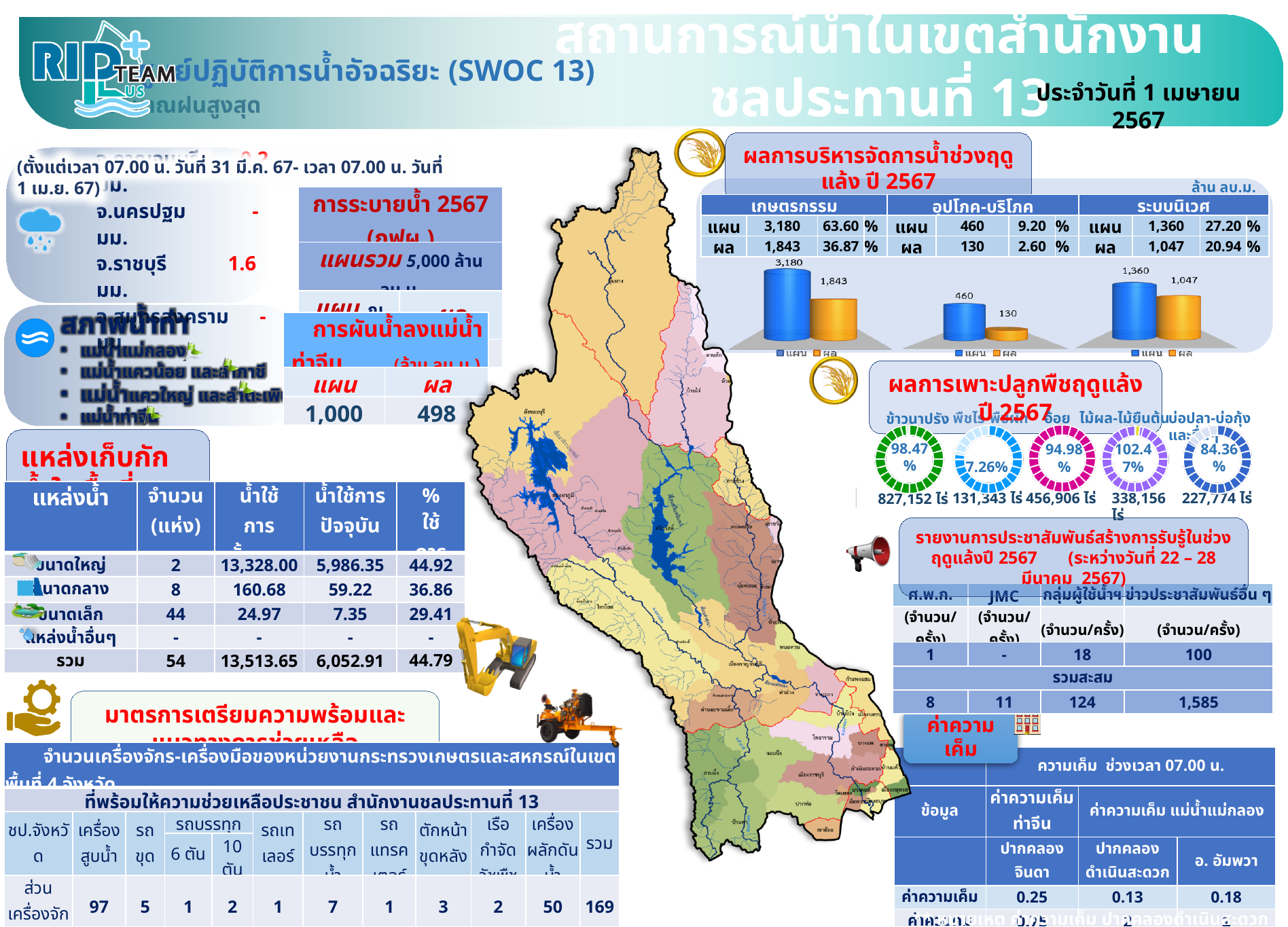
In the bar chart for เกษตรกรรม, which bar is taller, แผน or ผล? แผน In the bar chart for อุปโภค-บริโภค, what is the difference between the แผน and ผล bars? 330 How many series does the legend list in the bar chart for อุปโภค-บริโภค? 2 In the bar chart for ระบบนิเวศ, what is the difference between the แผน and ผล bars? 313 In the bar chart for เกษตรกรรม under ผลการบริหารจัดการน้ำช่วงฤดูแล้ง ปี 2567, what is the value of the แผน bar? 3,180 In the bar chart for เกษตรกรรม under ผลการบริหารจัดการน้ำช่วงฤดูแล้ง ปี 2567, what is the value of the ผล bar? 1,843 In the bar chart for อุปโภค-บริโภค, what is the value of the ผล bar? 130 In the ผลการเพาะปลูกพืชฤดูแล้ง ปี 2567 section, which crop's donut chart shows the lowest percentage? พืชไร่ พืชผัก In the ผลการเพาะปลูกพืชฤดูแล้ง ปี 2567 section, what percentage is shown in the donut chart for บ่อปลา-บ่อกุ้ง? 84.36% In the bar chart for ระบบนิเวศ, what is the value of the แผน bar? 1,360 In the ผลการเพาะปลูกพืชฤดูแล้ง ปี 2567 section, what percentage is shown in the donut chart for ข้าวนาปรัง? 98.47% What kind of chart is used to show แผน and ผล for เกษตรกรรม, อุปโภค-บริโภค and ระบบนิเวศ? bar chart